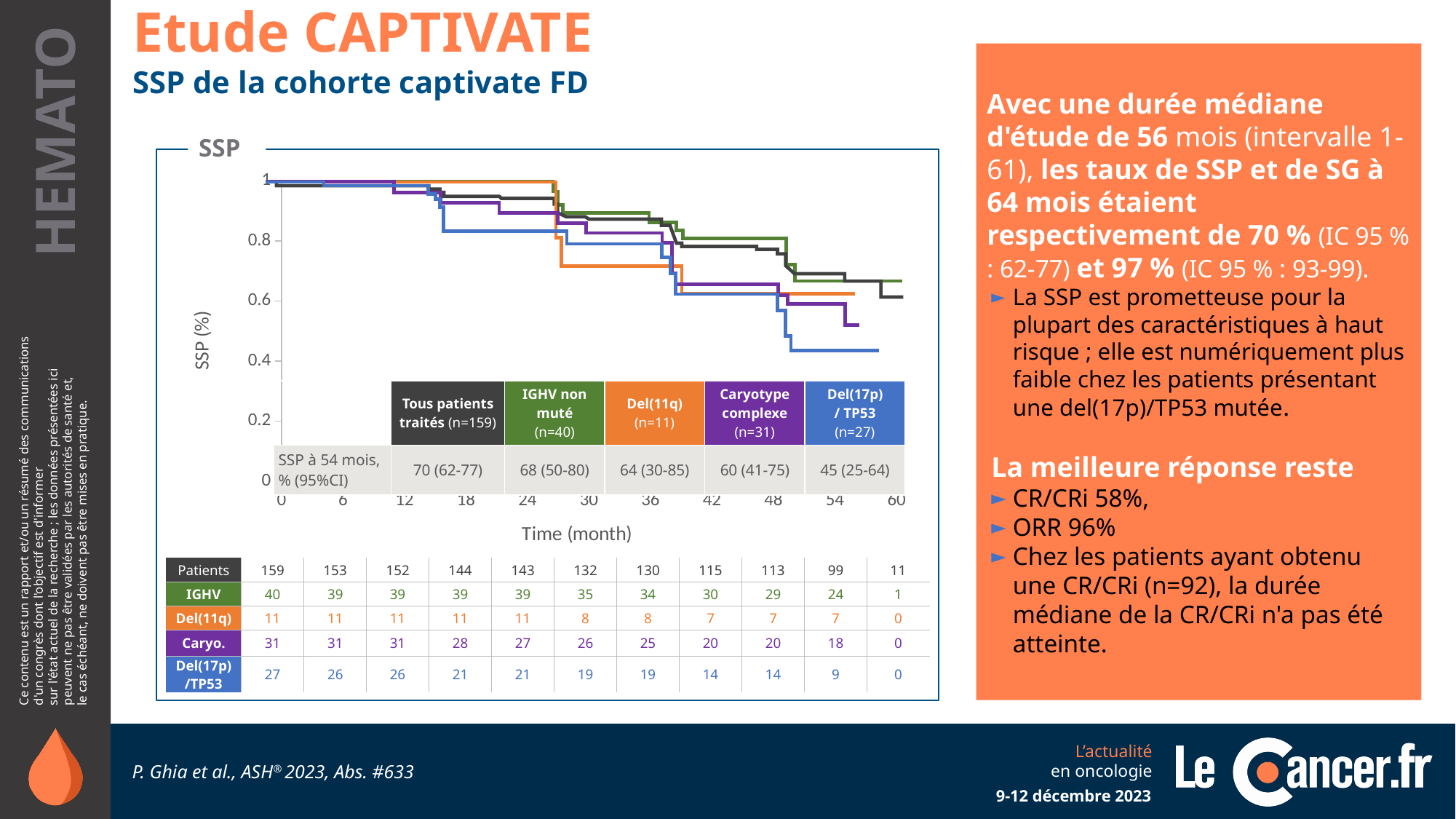
What kind of chart is shown on the slide? Line chart (Kaplan-Meier survival curve) What is the SSP at 54 months for all treated patients (Tous patients traités)? 70 (62-77) What is the SSP at 54 months for the Del(17p)/TP53 group? 45 (25-64) How many patient groups (curves) are plotted on the chart? 5 What is the difference in SSP at 54 months between all treated patients and the Del(17p)/TP53 group? 25 Which group has the lowest SSP at 54 months? Del(17p)/TP53 Is the Del(17p)/TP53 curve at 54 months greater or less than 0.6? less Which group has a higher SSP at 54 months, IGHV non muté or Del(11q)? IGHV non muté Which group has the highest SSP at 54 months? Tous patients traités How many Del(17p)/TP53 patients are at risk at 36 months? 19 Do the survival curves rise or fall as time increases? Fall How many patients are at risk at 60 months in the 'Patients' row? 11